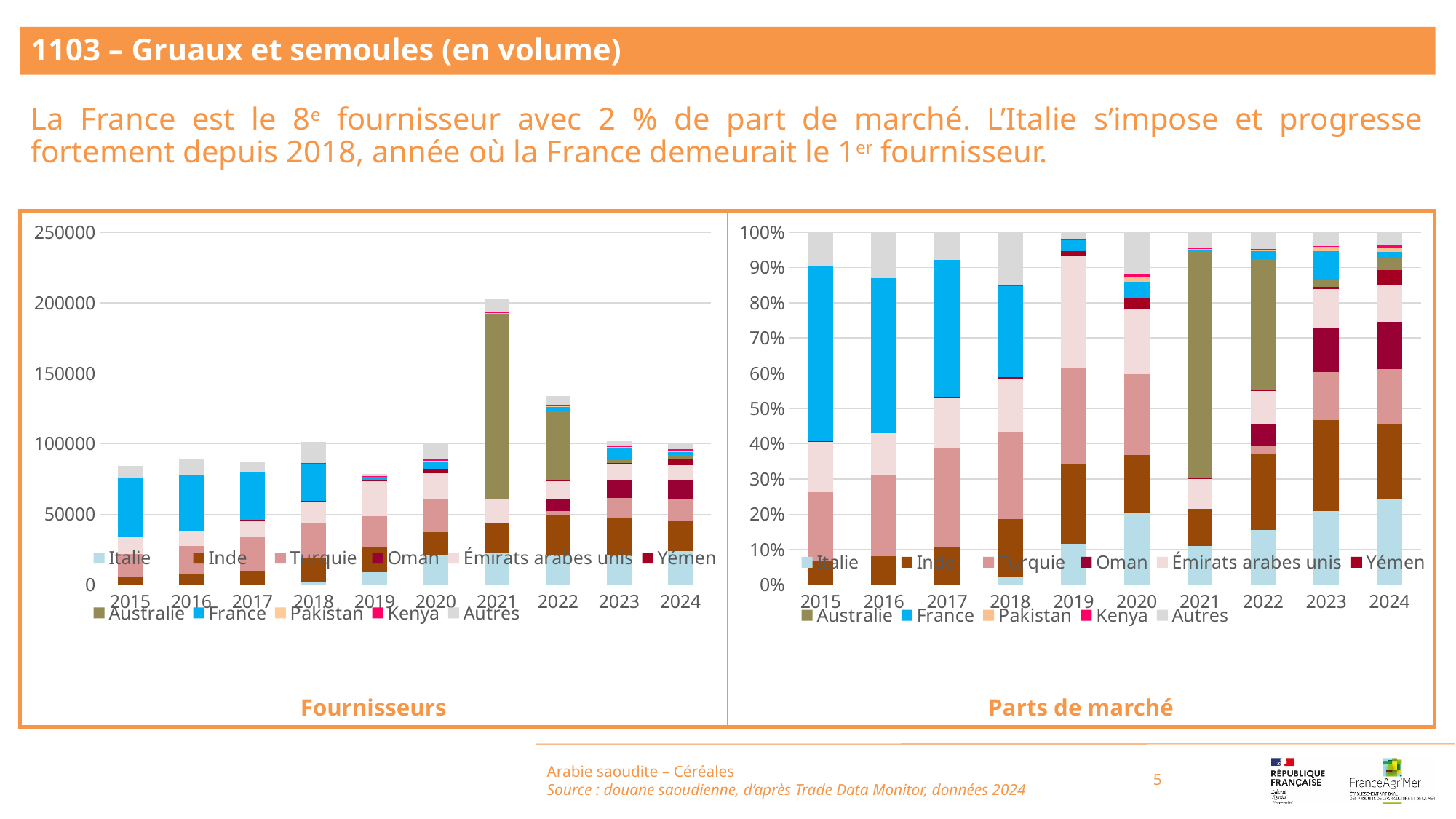
In the 'Fournisseurs' chart, which year has the highest total volume? 2021 What kind of chart is the 'Fournisseurs' chart on the left? stacked bar chart In the 'Fournisseurs' chart, is the total for 2019 greater or less than 100000? less In the 'Fournisseurs' chart, how many years are shown on the x axis? 10 What is the title of the chart on the right? Parts de marché In the 'Parts de marché' chart, is the share of France in 2015 greater or less than 40%? greater In the 'Parts de marché' chart, is the share of Italie in 2024 greater or less than 10%? greater In the 'Parts de marché' chart, how many series does the legend list? 11 In the 'Fournisseurs' chart, which year has the larger total volume, 2021 or 2022? 2021 What kind of chart is the 'Parts de marché' chart on the right? 100% stacked bar chart